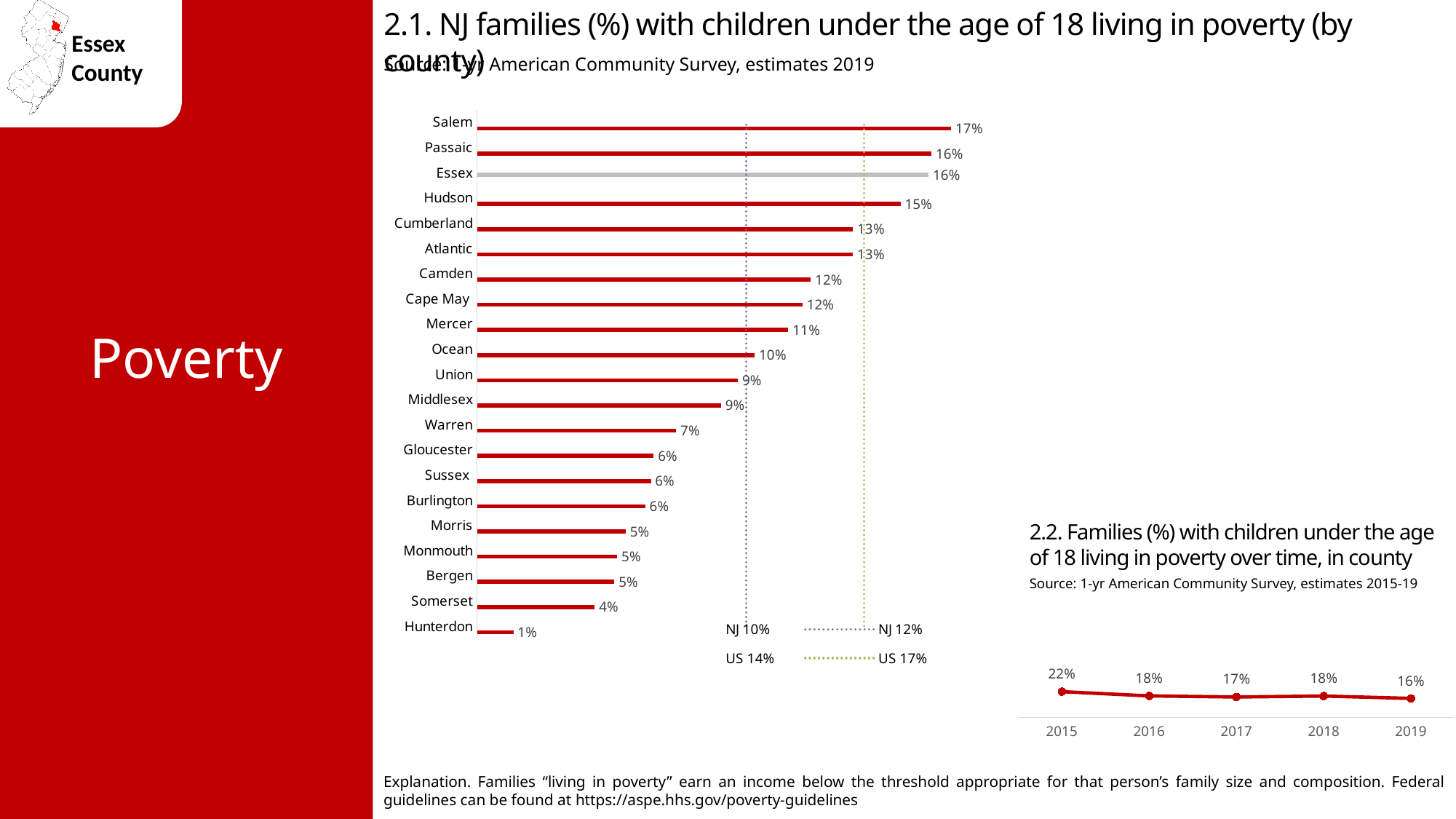
In chart 2.2, what is the difference between 2015 and 2019? 6% In chart 2.1, which county has the highest value? Salem In chart 2.1, which is larger, the value for Mercer or the value for Ocean? Mercer In chart 2.1, what is the value for Essex? 16% In chart 2.1, which county has the lowest value? Hunterdon In chart 2.2, what is the value for 2019? 16% In chart 2.2, what is the value for 2015? 22% In chart 2.2, how many years are plotted? 5 In chart 2.1, what is the value for Hudson? 15% In chart 2.1, how many counties are shown? 21 What kind of chart is chart 2.1? Bar chart In chart 2.1, what is the difference between Salem and Hunterdon? 16%